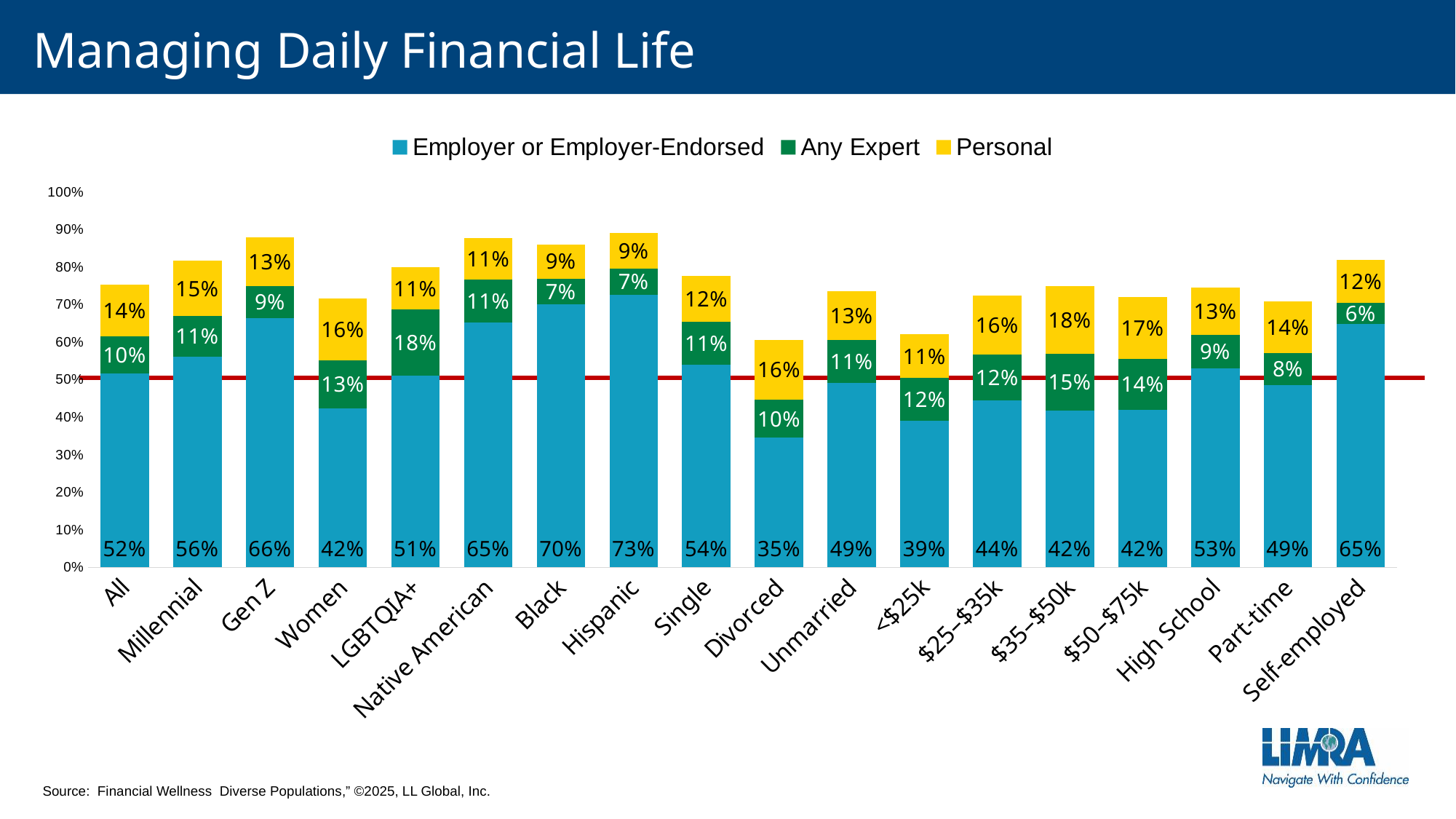
How many categories are shown along the x axis? 18 Which is larger, the Employer or Employer-Endorsed value for Black or for Native American? Black How many series does the legend list? 3 What is the Any Expert value for LGBTQIA+? 18% What is the difference between the Employer or Employer-Endorsed values for Gen Z and Women? 24% What is the Employer or Employer-Endorsed value for Hispanic? 73% Which category has the lowest Any Expert value? Self-employed Which category has the lowest Employer or Employer-Endorsed value? Divorced What kind of chart is shown on the slide? Stacked bar chart Which category has the highest Employer or Employer-Endorsed value? Hispanic What is the Personal value for Women? 16% What is the total of the stacked bar for Divorced? 61%